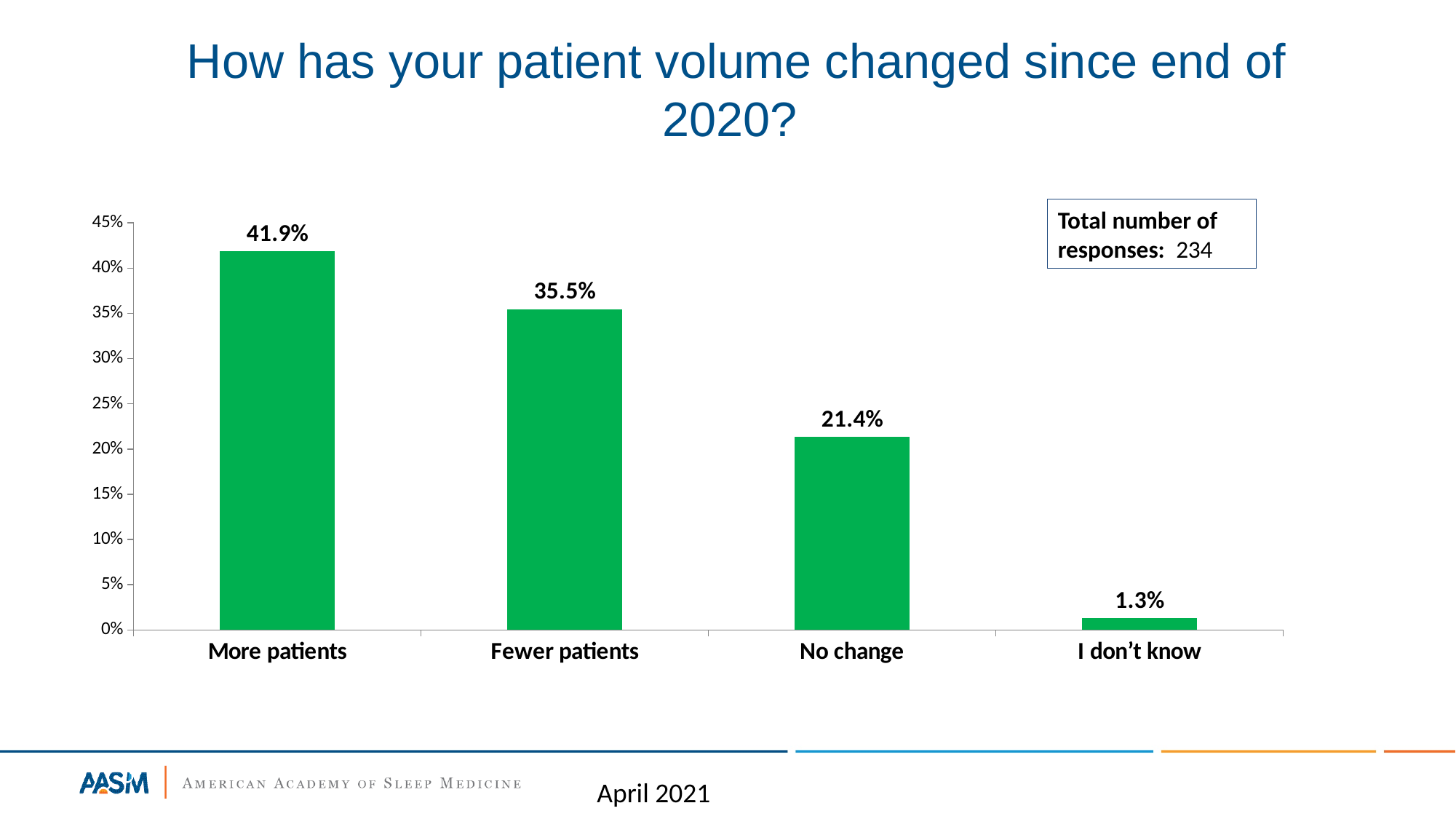
What type of chart is shown on the slide? Bar chart What is the difference in percentage points between 'Fewer patients' and 'No change'? 14.1 percentage points What percentage of respondents reported fewer patients? 35.5% What percentage of respondents reported no change in patient volume? 21.4% What percentage of respondents answered 'I don't know'? 1.3% Which response category has the highest percentage? More patients What is the total number of responses stated on the slide? 234 What is the difference in percentage points between 'More patients' and 'Fewer patients'? 6.4 percentage points Which is larger, the percentage for 'No change' or for 'Fewer patients'? Fewer patients Which response category has the lowest percentage? I don't know How many response categories are shown on the chart? 4 What percentage of respondents reported more patients? 41.9%